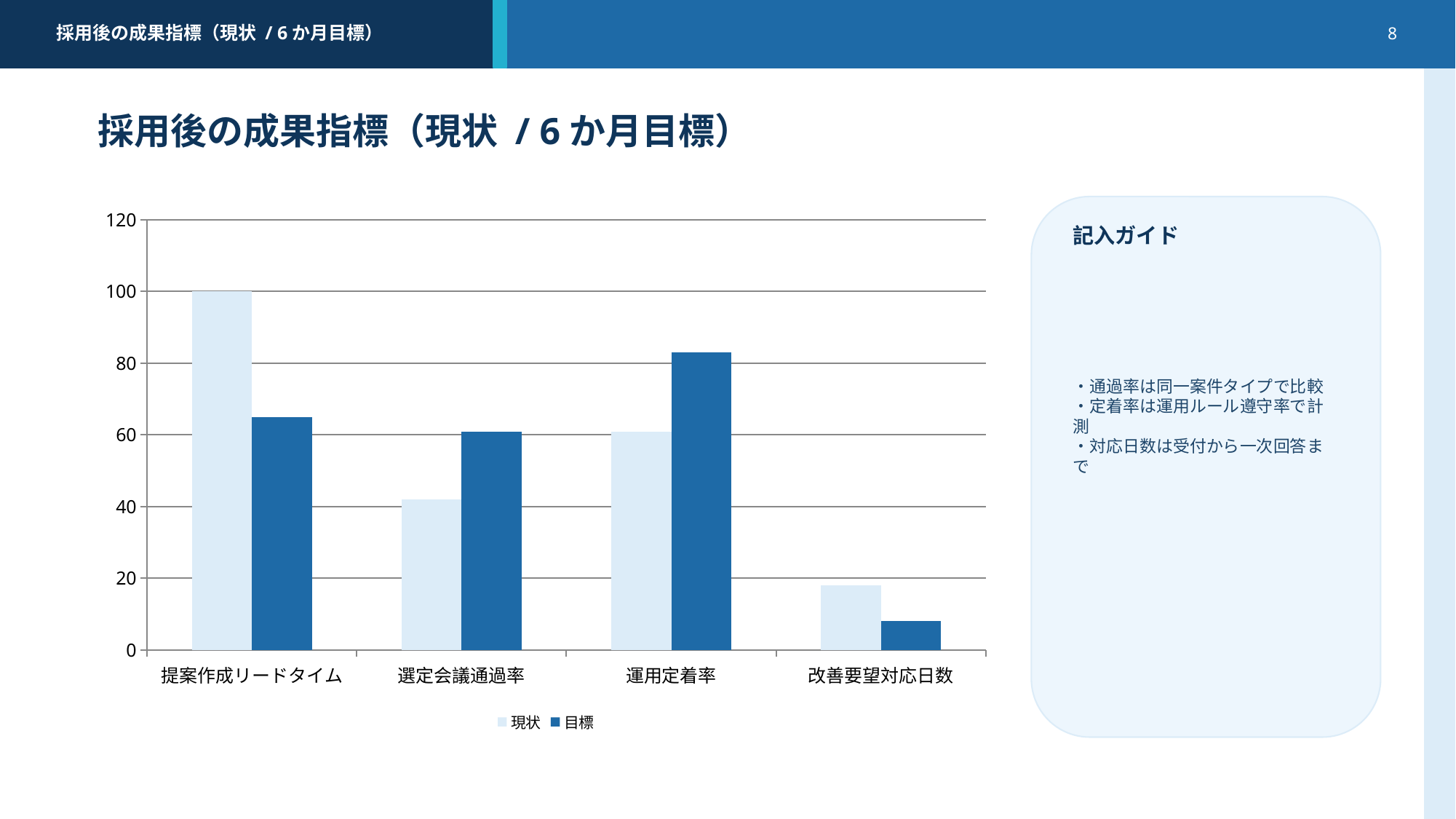
What is the 現状 value for 提案作成リードタイム? 100 What kind of chart is shown on the slide? bar chart Is the 現状 value for 選定会議通過率 greater or less than 60? less For 運用定着率, which is larger, the 現状 value or the 目標 value? 目標 How many series does the chart legend list? 2 Which category has the highest 現状 value? 提案作成リードタイム Is the 目標 value for 運用定着率 greater or less than 80? greater For 改善要望対応日数, which is larger, the 現状 value or the 目標 value? 現状 What are the two series listed in the chart legend? 現状, 目標 Which category has the lowest 目標 value? 改善要望対応日数 Which category has the highest 目標 value? 運用定着率 How many categories are shown on the x axis of the chart? 4